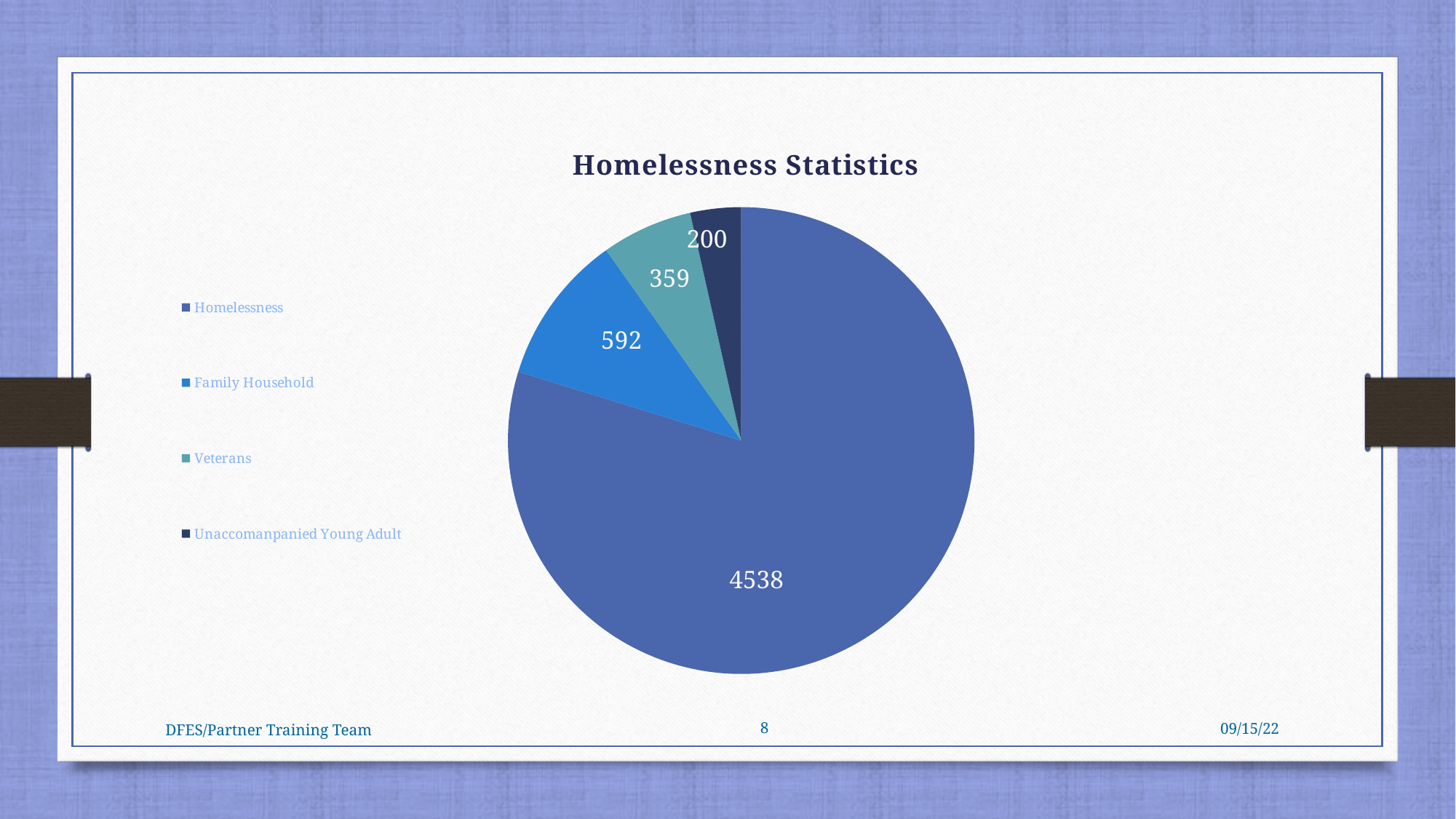
What is the difference between the Family Household value and the Veterans value? 233 Which category has the largest slice in the pie chart? Homelessness What is the title of the chart? Homelessness Statistics How many categories are shown in the pie chart? 4 What is the difference between the Homelessness value and the Family Household value? 3946 What kind of chart is shown on the slide? Pie chart Which is larger, the value for Veterans or the value for Unaccomanpanied Young Adult? Veterans What is the value for Unaccomanpanied Young Adult in the pie chart? 200 What is the value for Veterans in the pie chart? 359 What is the value for Family Household in the pie chart? 592 What is the value for Homelessness in the pie chart? 4538 Which category has the smallest slice in the pie chart? Unaccomanpanied Young Adult